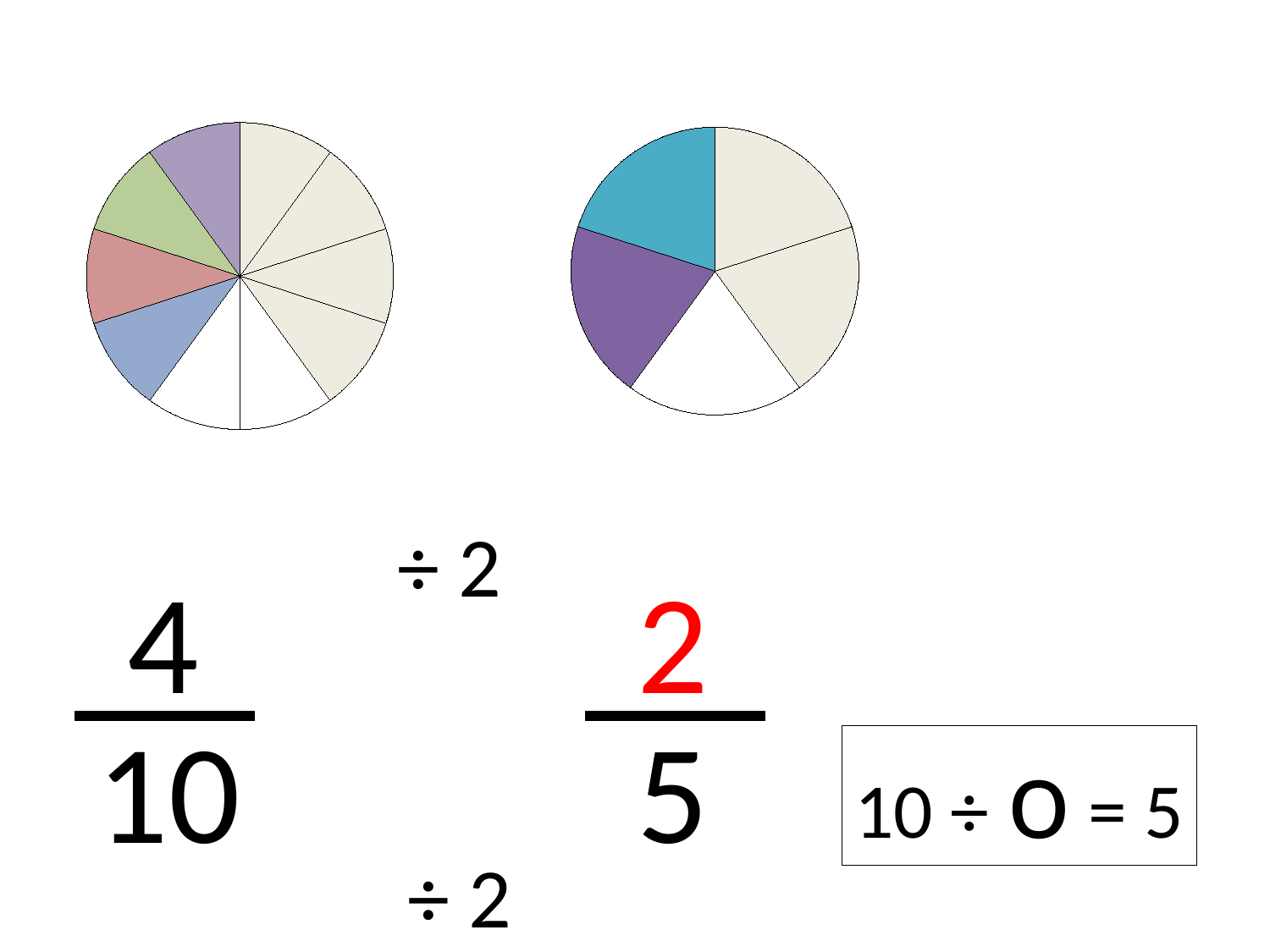
What kind of chart is shown on the right of the slide? pie chart According to the fraction printed under the right pie chart, what share of the pie do the coloured slices represent? 2/5 In the right pie chart, how many slices are shaded in a colour other than beige or white? 2 In the right pie chart, how many slices are white? 1 According to the fraction printed under the left pie chart, what share of the pie do the coloured slices represent? 4/10 Which pie chart is divided into more slices, the left one or the right one? the left one In the left pie chart, how many slices are shaded in a colour other than beige or white? 4 How many charts are on the slide? 2 What kind of chart is shown on the left of the slide? pie chart